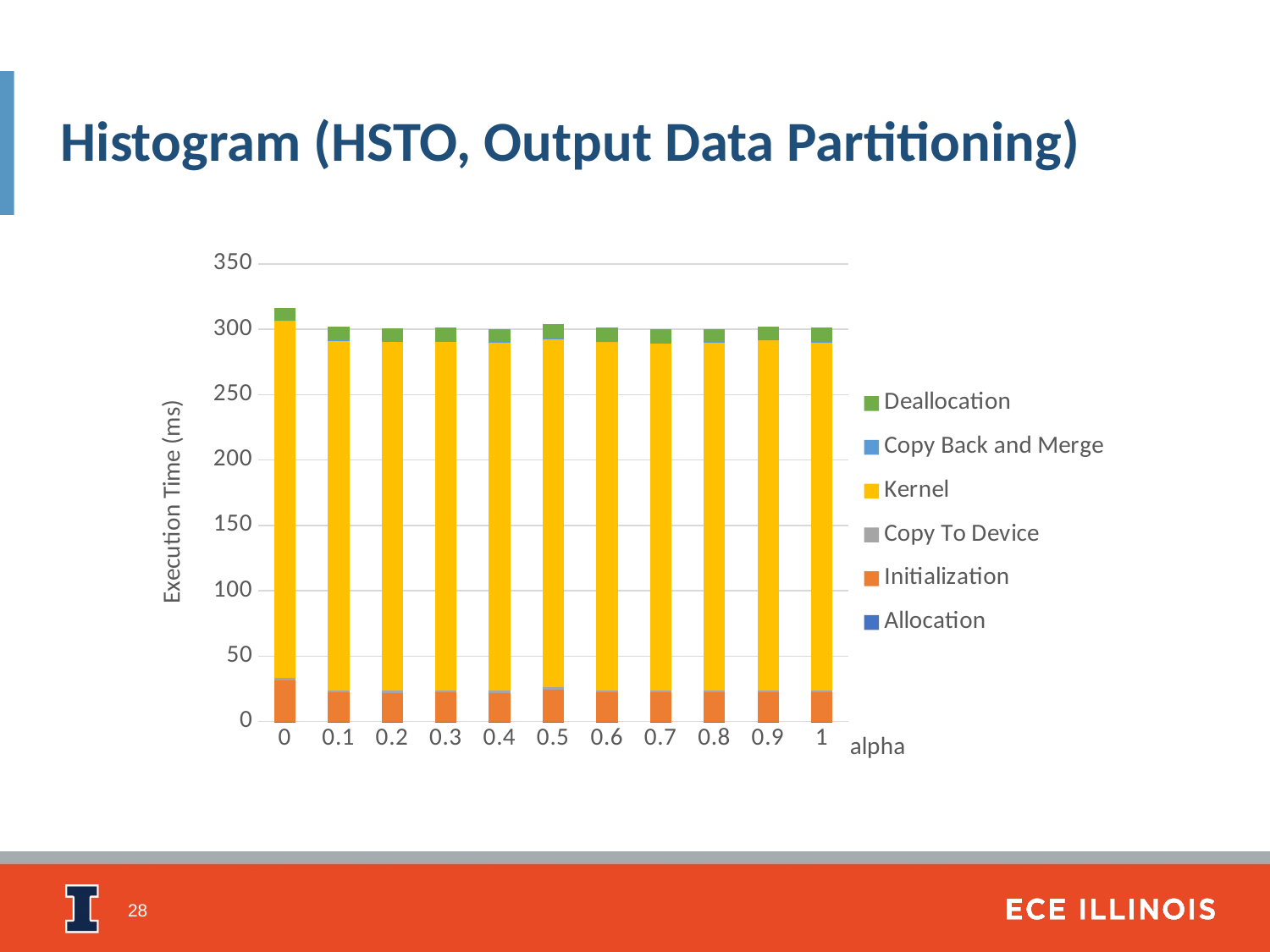
Is the total execution time for alpha = 0 greater or less than 300? greater What kind of chart is shown on the slide? stacked bar chart Which alpha value has the tallest total bar? 0 Is the Kernel segment for alpha = 0.3 greater or less than 200? greater What is the label of the y axis? Execution Time (ms) Is the Initialization segment for alpha = 0 greater or less than 50? less Which series accounts for the largest portion of each bar? Kernel What colour represents the Kernel series in the legend? yellow How many series does the legend list? 6 How many alpha values (bars) are plotted on the x axis? 11